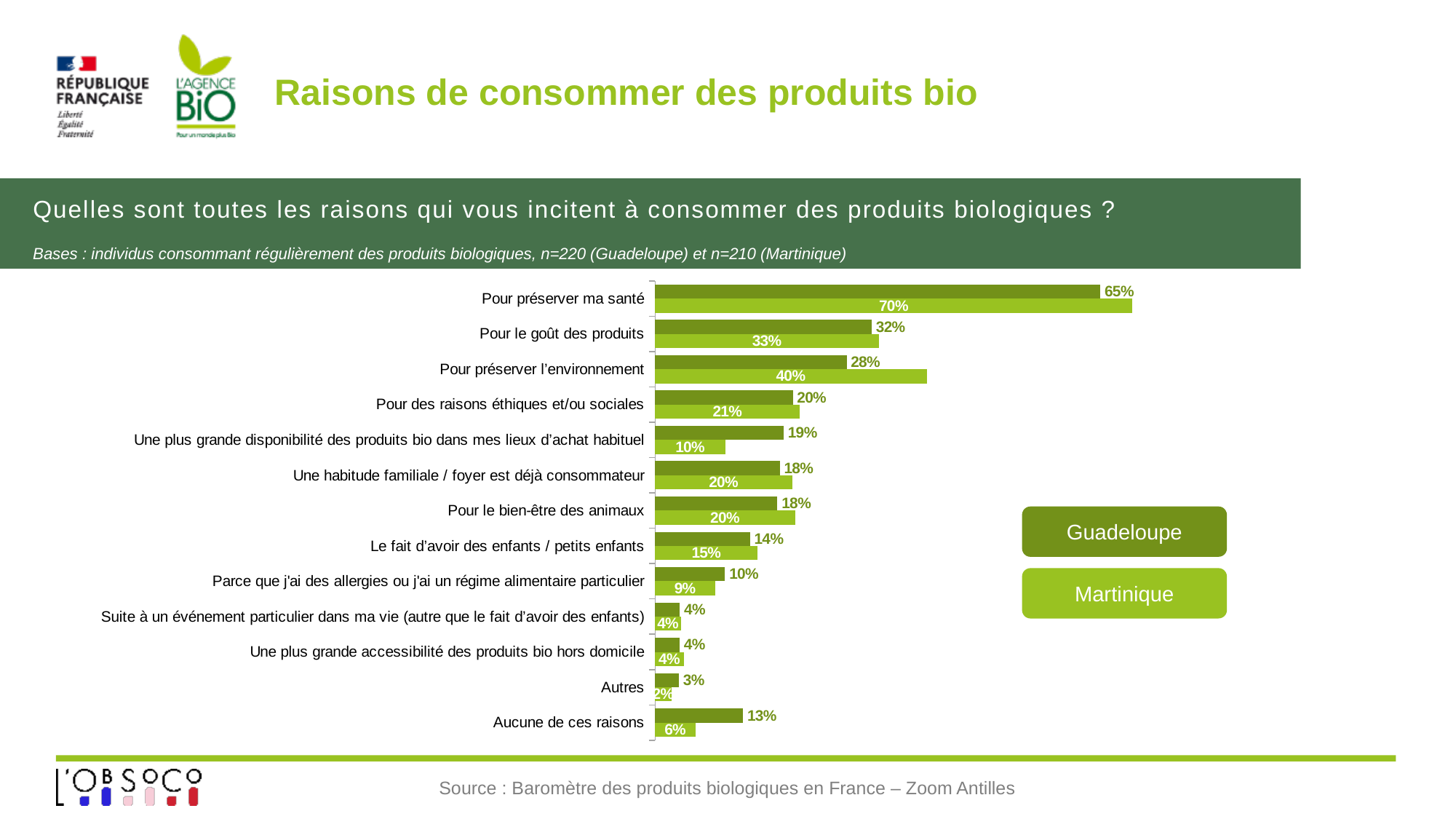
For "Une plus grande disponibilité des produits bio dans mes lieux d'achat habituel", which is larger: the Guadeloupe value or the Martinique value? Guadeloupe What is the difference between the Guadeloupe and Martinique values for "Aucune de ces raisons"? 7% What is the Guadeloupe value for "Pour préserver ma santé"? 65% What is the difference between the Martinique and Guadeloupe values for "Pour préserver l'environnement"? 12% What kind of chart is shown on the slide? Bar chart Which reason has the lowest Martinique value? Autres How many reasons (categories) are shown in the chart? 13 What is the Martinique value for "Aucune de ces raisons"? 6% What is the Martinique value for "Pour préserver l'environnement"? 40% Which reason has the highest Martinique value? Pour préserver ma santé How many series does the legend list? 2 For "Pour préserver ma santé", which is larger: the Guadeloupe value or the Martinique value? Martinique